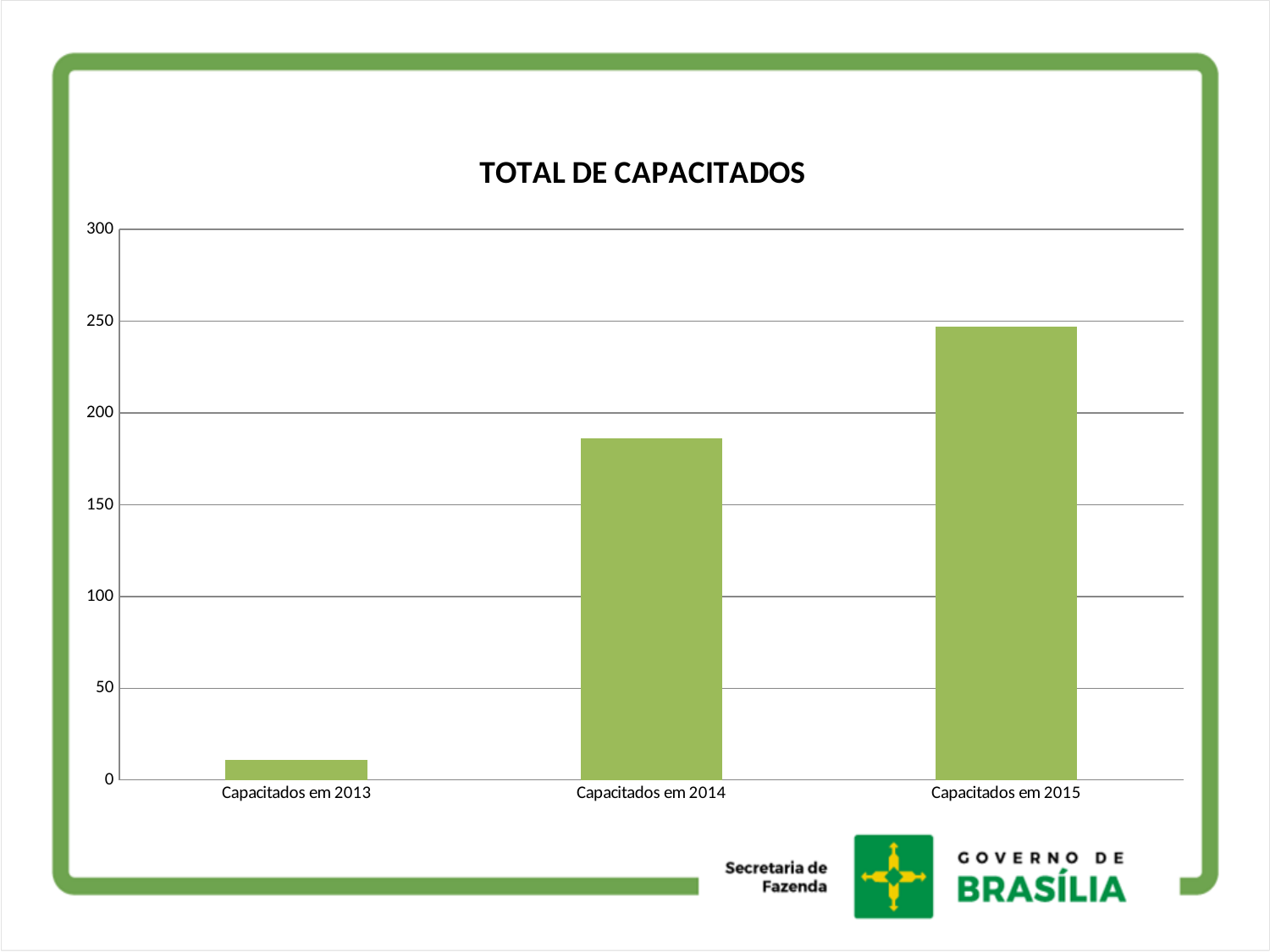
Which is larger, the value for Capacitados em 2013 or Capacitados em 2014? Capacitados em 2014 Do the values rise or fall from Capacitados em 2013 to Capacitados em 2015? rise Is the value for Capacitados em 2014 greater or less than 200? less Is the value for Capacitados em 2013 greater or less than 50? less Which category has the highest value? Capacitados em 2015 Is the value for Capacitados em 2014 greater or less than 150? greater Which is larger, the value for Capacitados em 2014 or Capacitados em 2015? Capacitados em 2015 Which category has the lowest value? Capacitados em 2013 What is the title of the chart? TOTAL DE CAPACITADOS How many categories are shown on the x axis of the chart? 3 What kind of chart is shown on the slide? bar chart